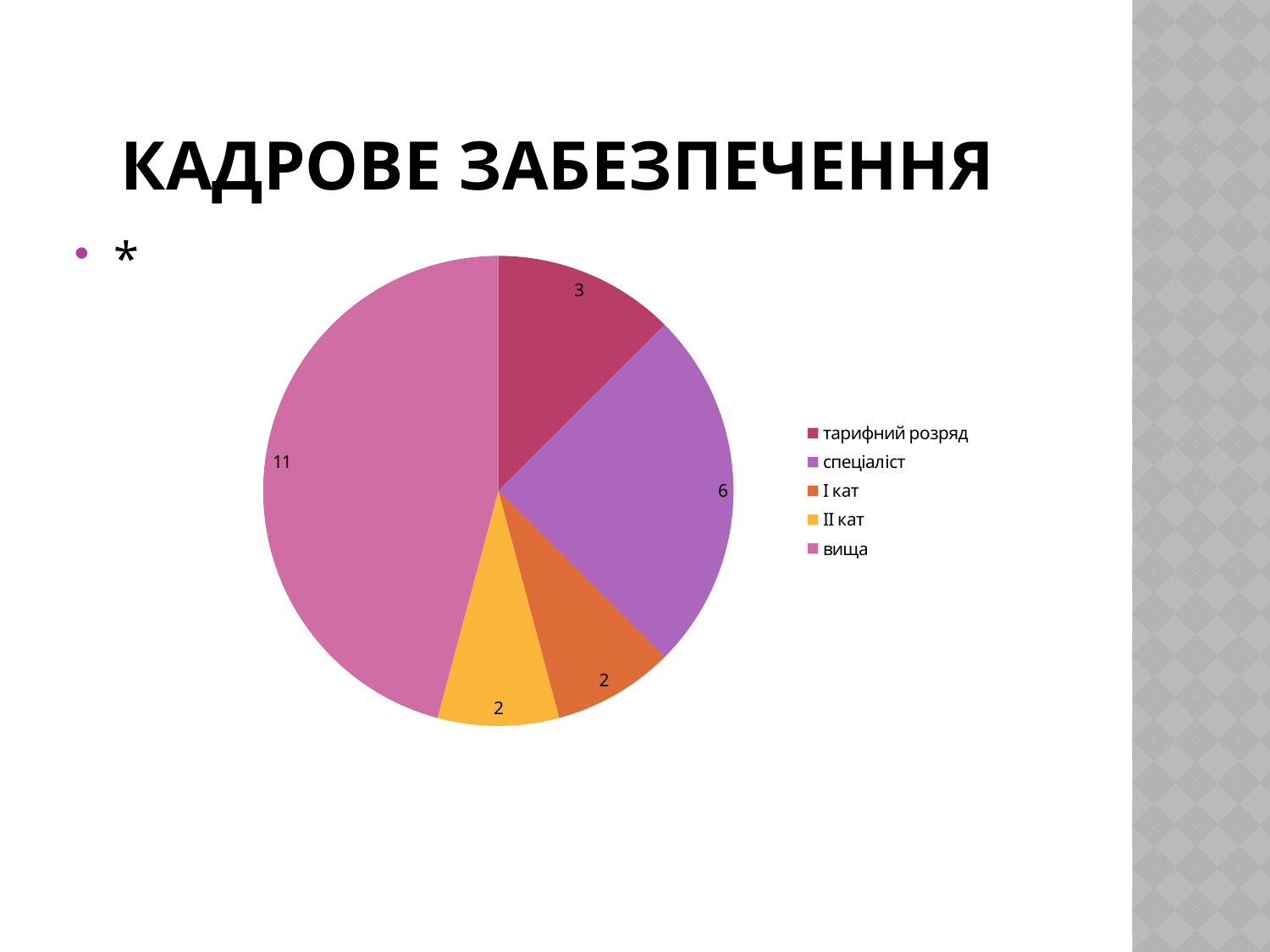
Which is larger, the value for "спеціаліст" or the value for "тарифний розряд"? спеціаліст What value is shown for the "I кат" slice of the pie chart? 2 What type of chart is shown on the slide? pie chart How many slices does the pie chart have? 5 What is the title of the slide containing the pie chart? КАДРОВЕ ЗАБЕЗПЕЧЕННЯ What value is shown for the "тарифний розряд" slice of the pie chart? 3 What is the difference between the values for "вища" and "спеціаліст"? 5 What share of the pie does the "спеціаліст" slice represent? 25% What is the difference between the values for "спеціаліст" and "тарифний розряд"? 3 What value is shown for the "спеціаліст" slice of the pie chart? 6 Which category has the largest slice in the pie chart? вища What value is shown for the "вища" slice of the pie chart? 11